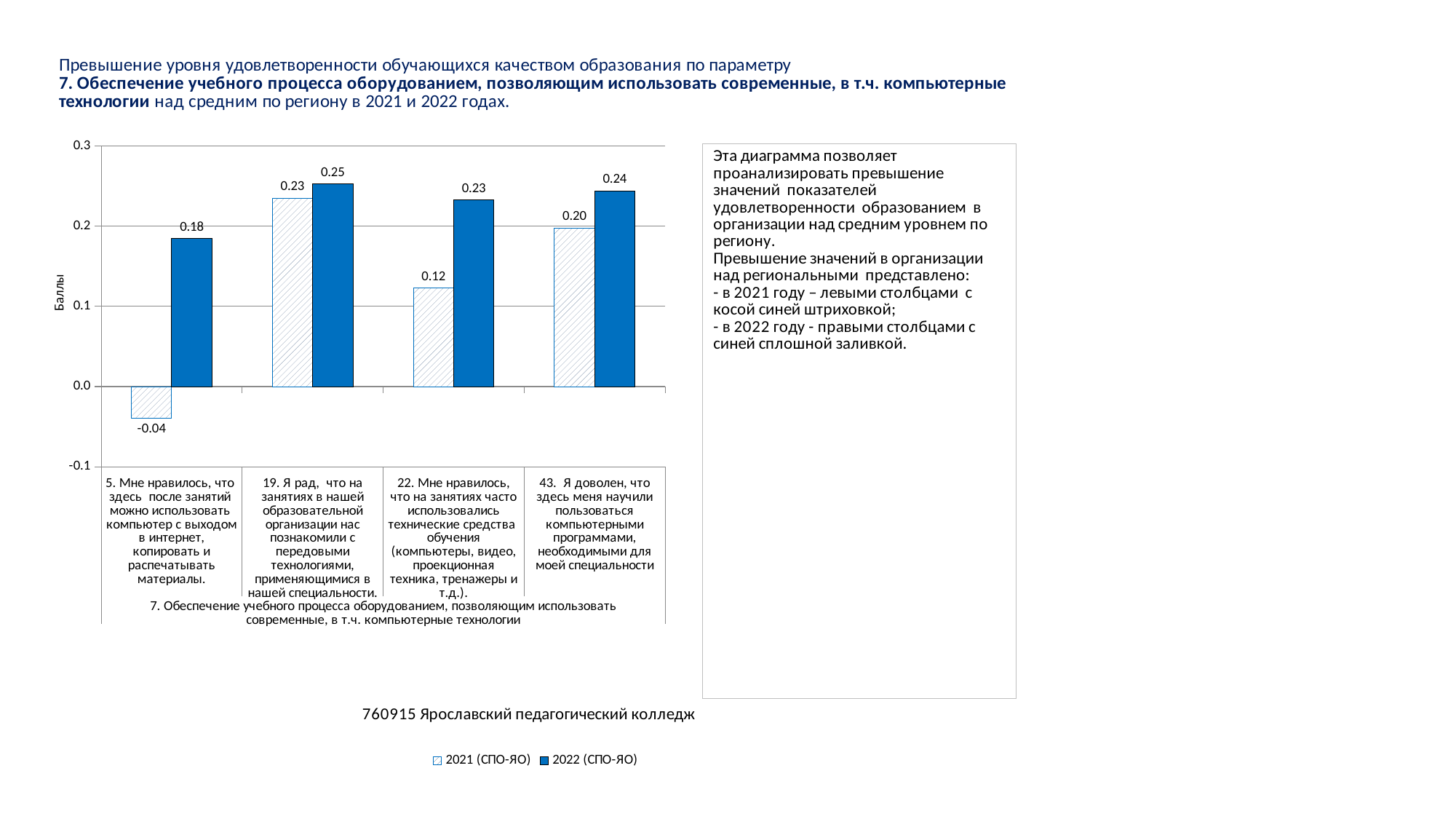
Which category has the lowest 2021 (СПО-ЯО) value? 5. Мне нравилось, что здесь после занятий можно использовать компьютер с выходом в интернет, копировать и распечатывать материалы. For category 43, which is larger: the 2021 (СПО-ЯО) value or the 2022 (СПО-ЯО) value? 2022 (СПО-ЯО) How many categories are shown on the x axis of the chart? 4 What type of chart is shown on the slide? Bar chart What is the 2022 (СПО-ЯО) value for category 19 ("Я рад, что на занятиях в нашей образовательной организации нас познакомили с передовыми технологиями...")? 0.25 Which category has the highest 2022 (СПО-ЯО) value? 19. Я рад, что на занятиях в нашей образовательной организации нас познакомили с передовыми технологиями, применяющимися в нашей специальности. What is the label of the y axis of the chart? Баллы What is the 2022 (СПО-ЯО) value for category 43 ("Я доволен, что здесь меня научили пользоваться компьютерными программами...")? 0.24 How many series does the legend list? 2 What is the difference between the 2022 and 2021 values for category 22? 0.11 What is the 2021 (СПО-ЯО) value for category 5 ("Мне нравилось, что здесь после занятий можно использовать компьютер...")? -0.04 What is the 2021 (СПО-ЯО) value for category 22 ("Мне нравилось, что на занятиях часто использовались технические средства обучения...")? 0.12